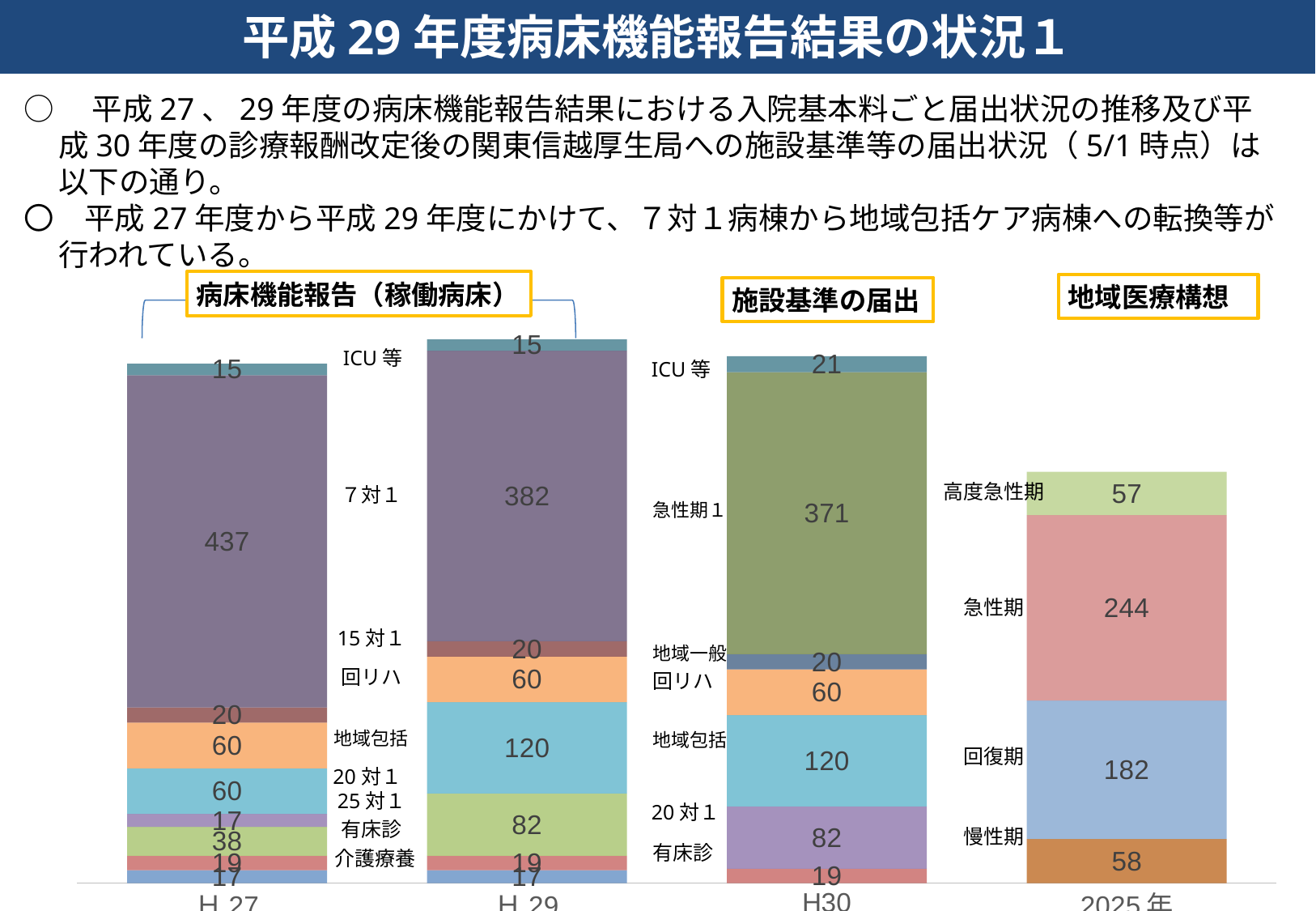
What is the value of the 急性期1 segment in the H30 bar? 371 What is the value of the 7対1 segment in the H29 bar? 382 By how much did the 7対1 segment decrease from H27 to H29? 55 What is the difference between the 地域包括 values in H29 and H27? 60 What is the value of the 7対1 segment in the H27 bar? 437 How many stacked bars are shown in the chart? 4 What kind of chart is shown on the slide? Stacked bar chart Which segment is the largest in the 2025年 bar? 急性期 What is the value of the 地域包括 segment in the H29 bar? 120 What is the total of the 2025年 stacked bar? 541 What is the value of the ICU等 segment in the H30 bar? 21 What is the value of the 回復期 segment in the 2025年 bar? 182